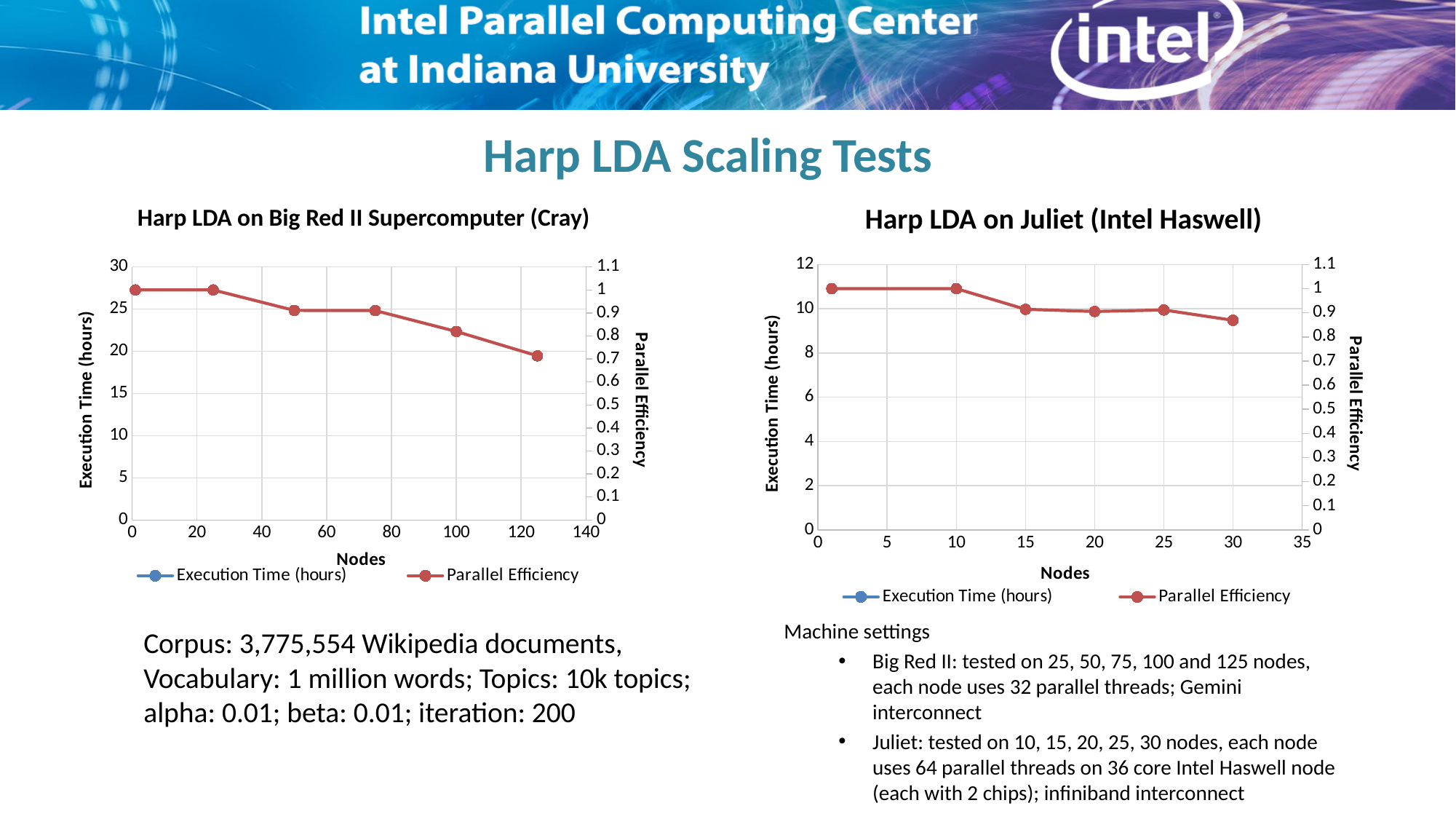
In "Harp LDA on Big Red II Supercomputer (Cray)", at which number of nodes is Parallel Efficiency lowest? 125 What kind of chart is "Harp LDA on Big Red II Supercomputer (Cray)"? line chart In "Harp LDA on Juliet (Intel Haswell)", does Parallel Efficiency rise or fall as the number of nodes increases? fall In "Harp LDA on Big Red II Supercomputer (Cray)", is the Parallel Efficiency at 125 nodes greater or less than 0.8? less In "Harp LDA on Big Red II Supercomputer (Cray)", does Parallel Efficiency rise or fall as the number of nodes increases? fall How many series does the legend of "Harp LDA on Juliet (Intel Haswell)" list? 2 In "Harp LDA on Big Red II Supercomputer (Cray)", which is larger: Parallel Efficiency at 50 nodes or at 125 nodes? 50 nodes In "Harp LDA on Big Red II Supercomputer (Cray)", how many data points are plotted on the Parallel Efficiency line? 6 In "Harp LDA on Big Red II Supercomputer (Cray)", is the Parallel Efficiency at 100 nodes greater or less than 0.9? less In "Harp LDA on Juliet (Intel Haswell)", at which number of nodes is Parallel Efficiency lowest? 30 In "Harp LDA on Juliet (Intel Haswell)", is the Parallel Efficiency at 30 nodes greater or less than 0.8? greater In "Harp LDA on Juliet (Intel Haswell)", how many data points are plotted on the Parallel Efficiency line? 6